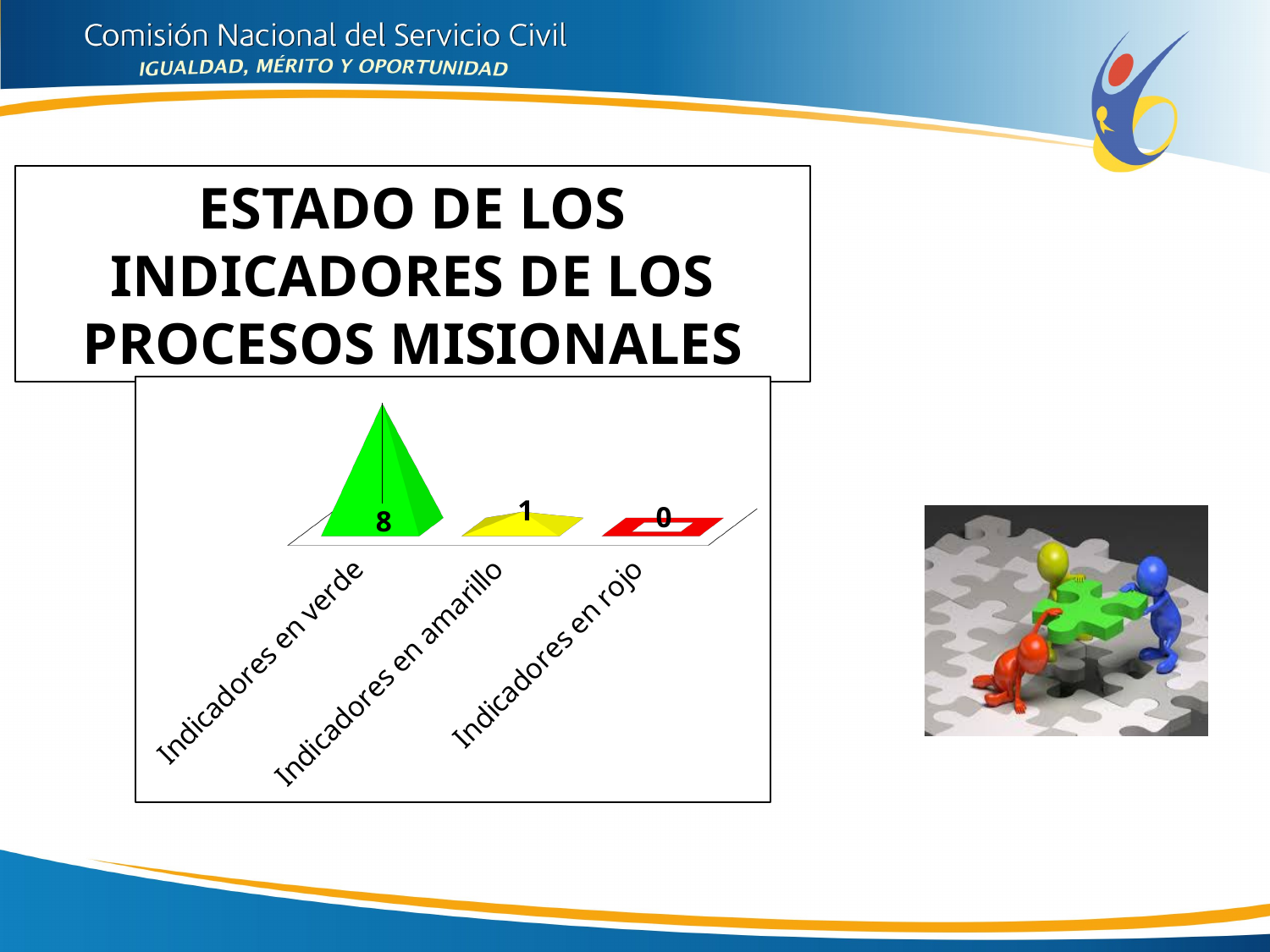
What is the value for Indicadores en amarillo? 1 What is the total of the three values shown in the chart? 9 What is the value for Indicadores en rojo? 0 What colour is the bar for Indicadores en amarillo? Yellow Which category has the lowest value? Indicadores en rojo What kind of chart is shown on the slide? Bar chart Which is larger, the value for Indicadores en amarillo or Indicadores en rojo? Indicadores en amarillo How many categories are shown in the chart? 3 What is the difference between the values for Indicadores en verde and Indicadores en amarillo? 7 Which category has the highest value? Indicadores en verde Do the values rise or fall from left to right across the categories? Fall What is the value for Indicadores en verde? 8